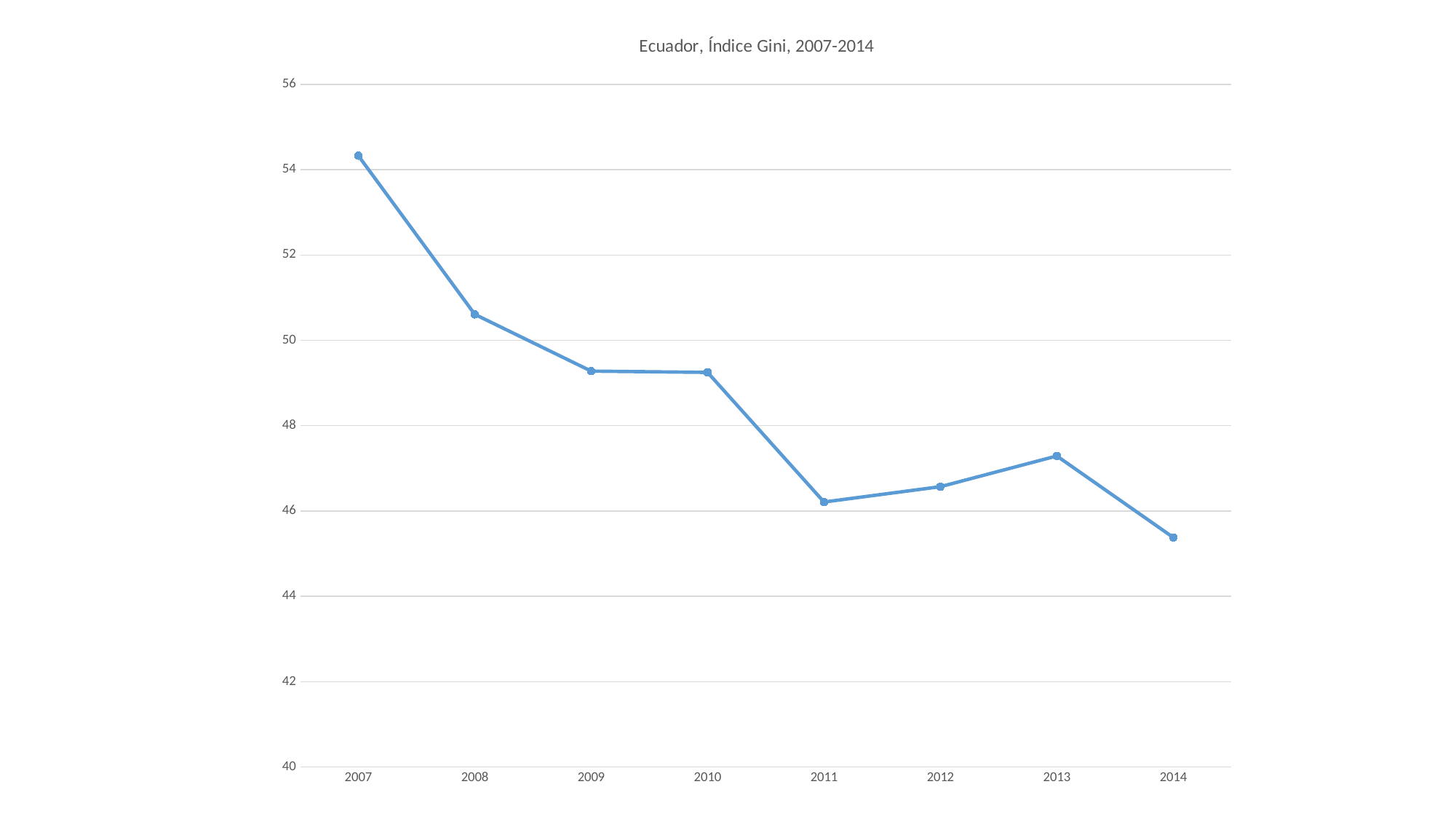
How many years are plotted on the x axis? 8 Is the value for 2007 greater or less than 54? greater Which year has the highest Gini index value? 2007 Is the value for 2014 greater or less than 46? less Which year has the lowest Gini index value? 2014 Is the value for 2008 greater or less than 50? greater Overall, do the values rise or fall from 2007 to 2014? fall Which year has the larger value, 2012 or 2013? 2013 What is the title of the chart? Ecuador, Índice Gini, 2007-2014 What kind of chart is shown on the slide? line chart